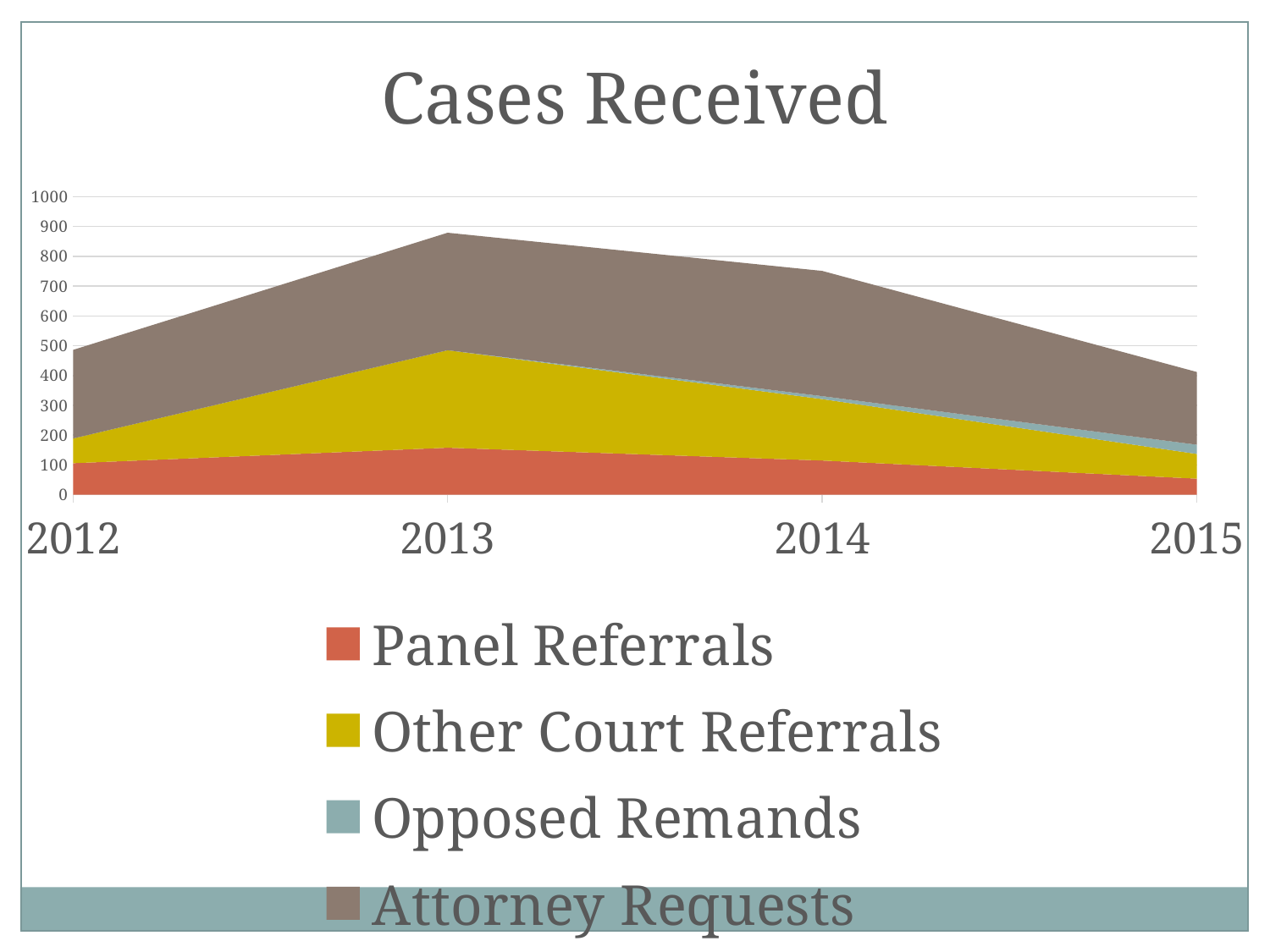
Is the total stacked value for 2015 greater or less than 300? greater What kind of chart is shown on the slide? Stacked area chart Is the total stacked value for 2014 greater or less than 700? greater Is the total stacked value for 2013 greater or less than 800? greater How many years are plotted along the x axis? 4 How does the total of cases received change from 2013 to 2015? It falls Which series is shown in the topmost (brown) band of the chart? Attorney Requests In which year is the total of all stacked series highest? 2013 What is the title of the chart? Cases Received How many series does the legend list? 4 In which year is the total of all stacked series lowest? 2015